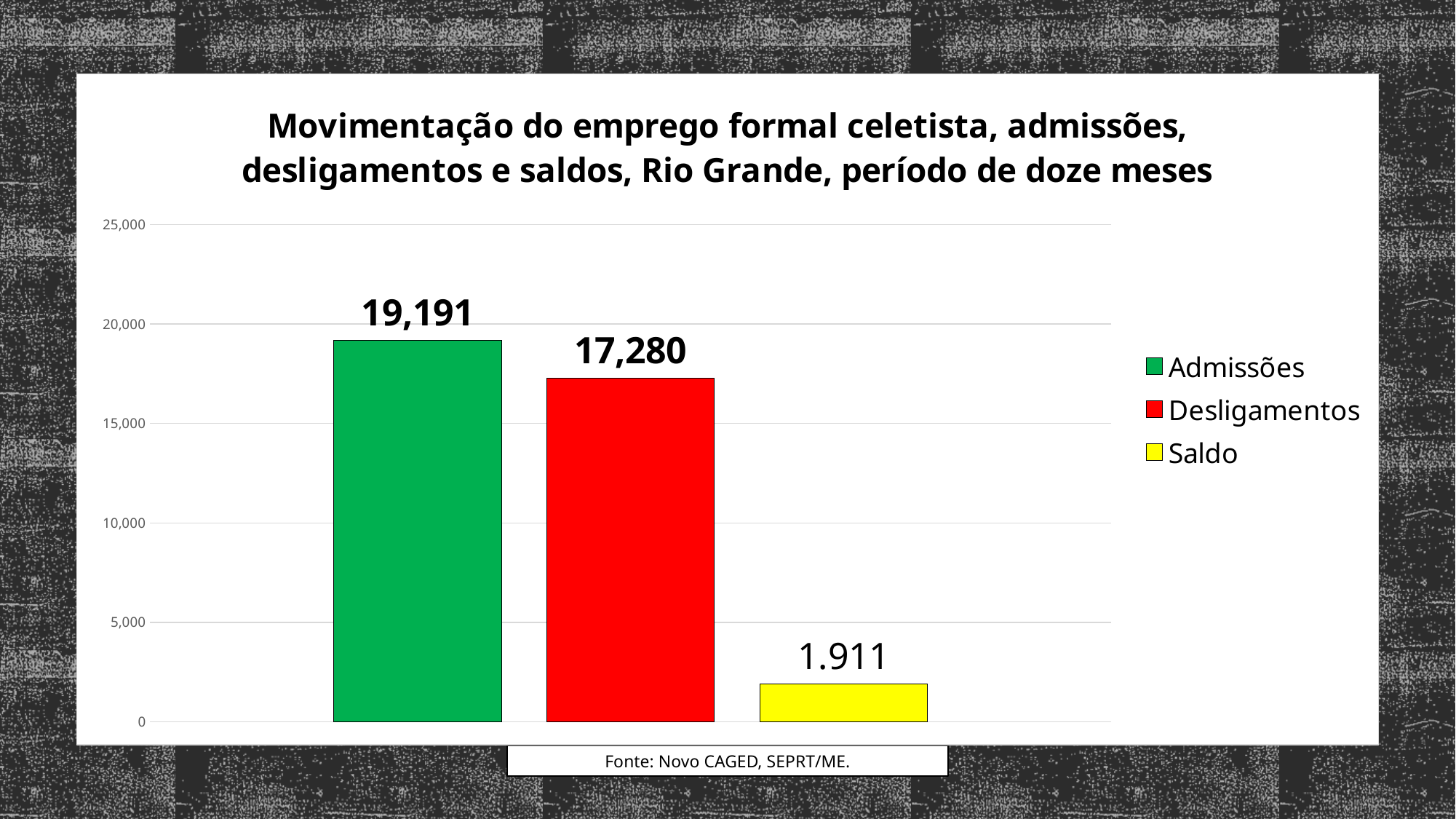
Is the value for Desligamentos greater or less than 15,000? greater What is the difference between Admissões and Desligamentos? 1,911 How many bars are plotted in the chart? 3 Which series has the lowest value? Saldo Which is larger, Admissões or Desligamentos? Admissões Is the value for Saldo greater or less than 5,000? less What value is printed on the Saldo bar? 1.911 Which series has the highest value? Admissões How many series does the legend list? 3 What is the value for Desligamentos? 17,280 What is the value for Admissões? 19,191 What kind of chart is shown on the slide? Bar chart